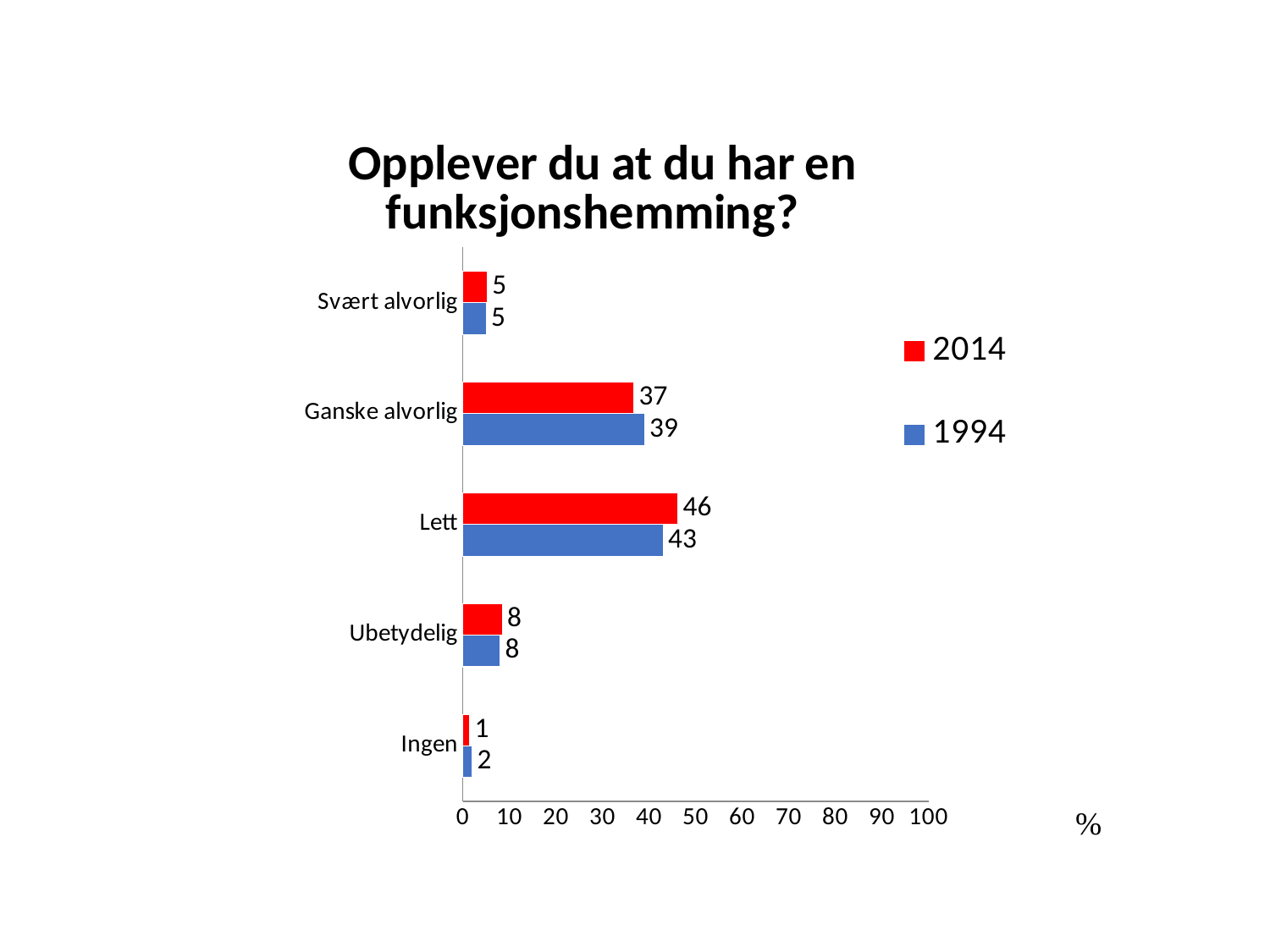
What is the value for Ganske alvorlig in the 1994 series? 39 Which category has the highest value in the 2014 series? Lett Which is larger for Ganske alvorlig: the 2014 value or the 1994 value? 1994 What is the value for Lett in the 2014 series? 46 How many series does the legend list? 2 What is the title of the chart? Opplever du at du har en funksjonshemming? What is the value for Ingen in the 2014 series? 1 What is the difference between the 1994 and 2014 values for Ganske alvorlig? 2 What is the difference between the 2014 and 1994 values for Lett? 3 How many categories are shown on the chart? 5 Which category has the lowest value in the 1994 series? Ingen What kind of chart is shown on the slide? Bar chart